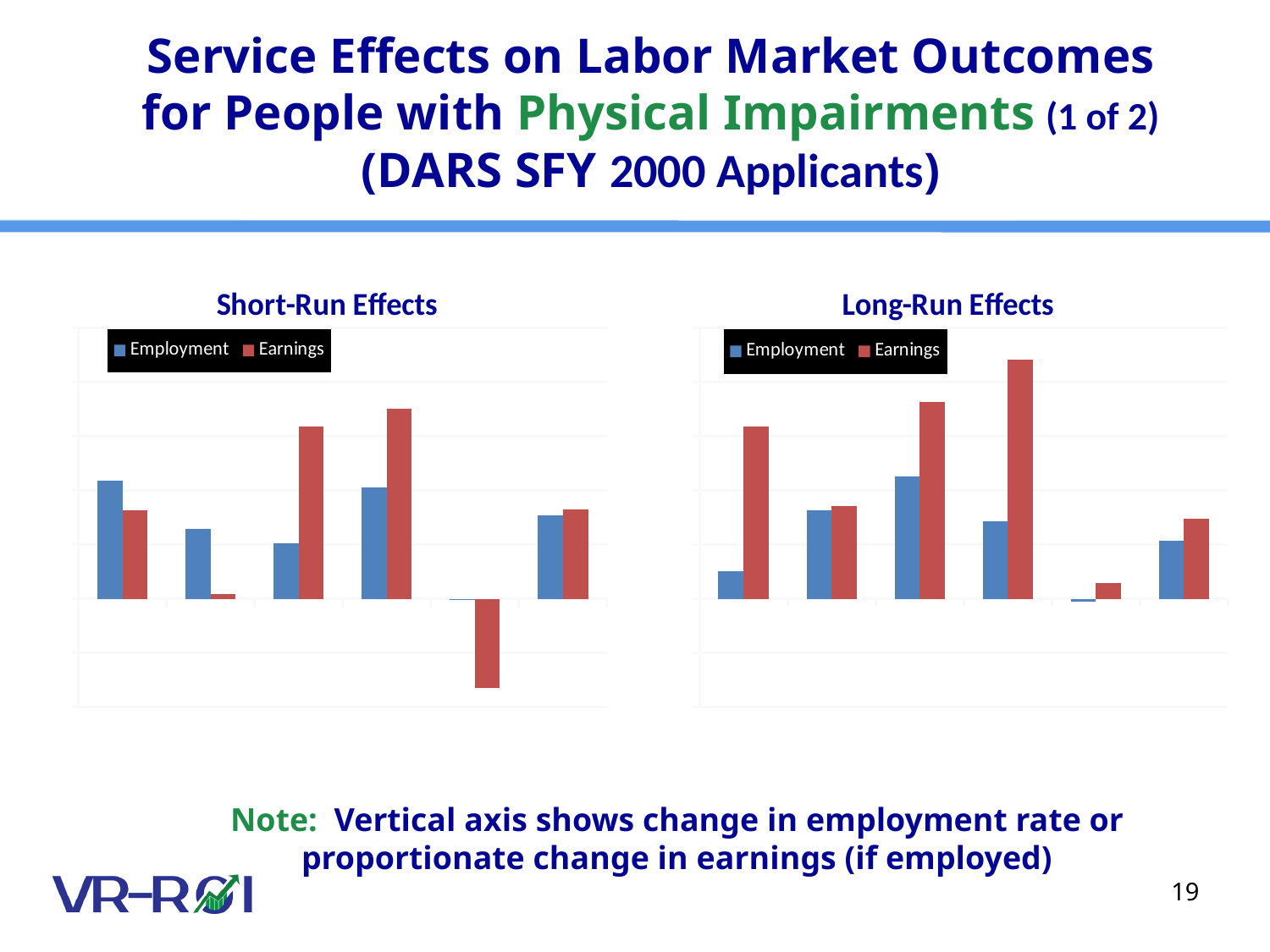
How many series does the legend of the Long-Run Effects chart list? 2 In the Short-Run Effects chart, which series contains the bar that extends furthest below the horizontal axis? Earnings What are the two series named in the legend of the Short-Run Effects chart? Employment and Earnings What kind of chart is the Short-Run Effects chart? Bar chart In the Short-Run Effects chart, which series contains the tallest bar? Earnings What kind of chart is the Long-Run Effects chart? Bar chart How many groups of bars are plotted in the Short-Run Effects chart? 6 How many groups of bars are plotted in the Long-Run Effects chart? 6 In the Long-Run Effects chart, what colour are the Earnings bars? Red In the Long-Run Effects chart, which series contains the tallest bar? Earnings How many series does the legend of the Short-Run Effects chart list? 2